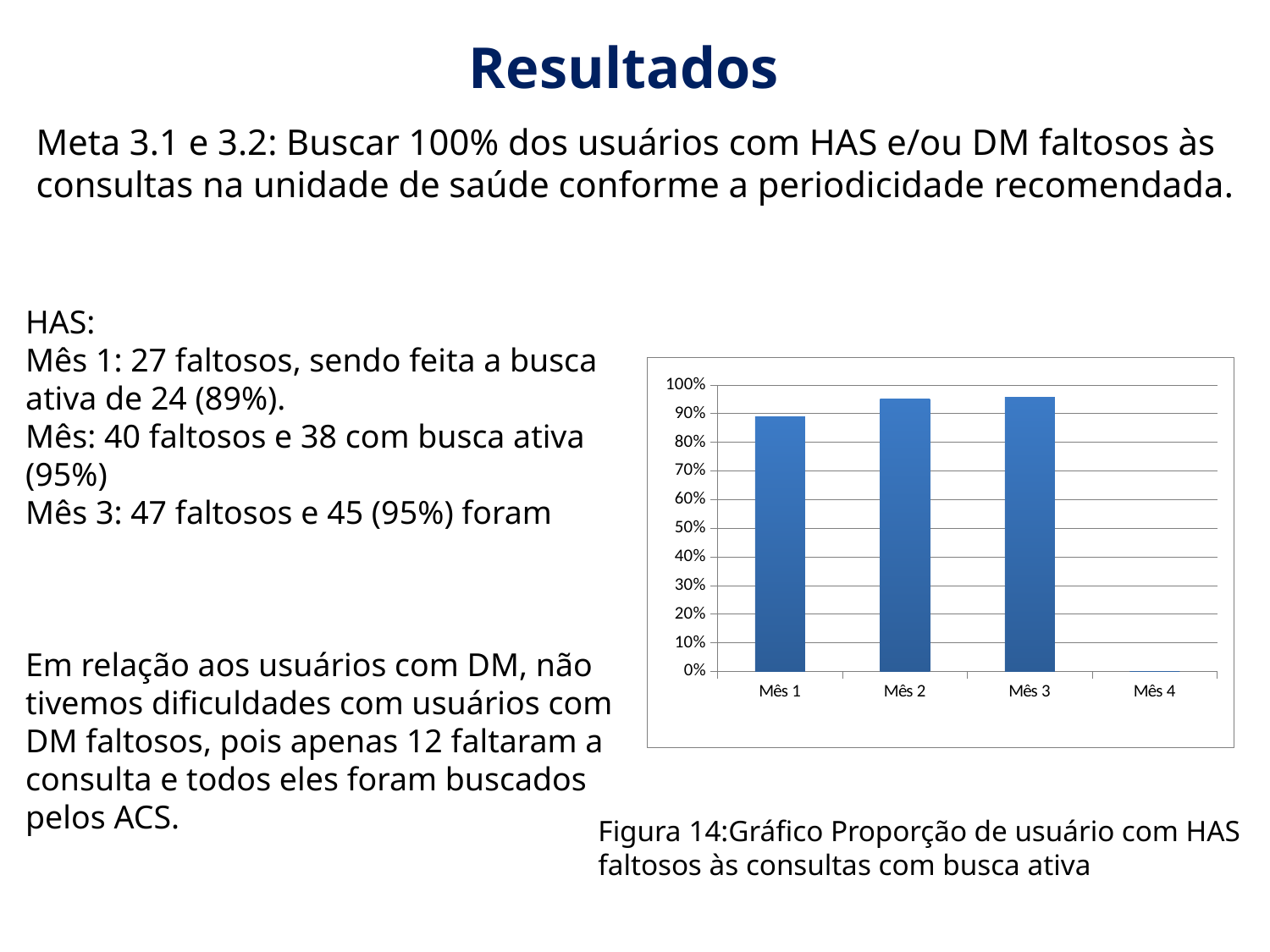
Is the value for Mês 1 greater or less than 100%? less Is the value for Mês 3 greater or less than 90%? greater What kind of chart is shown on the slide? bar chart How many categories are shown on the x axis of the chart? 4 Which category on the x axis has no bar plotted? Mês 4 Is the value for Mês 1 greater or less than 80%? greater Which is larger, the value for Mês 1 or the value for Mês 2? Mês 2 Among the months that have a bar plotted, which has the lowest value? Mês 1 What is the figure number given in the caption below the chart? Figura 14 Do the values rise or fall from Mês 1 to Mês 3? rise